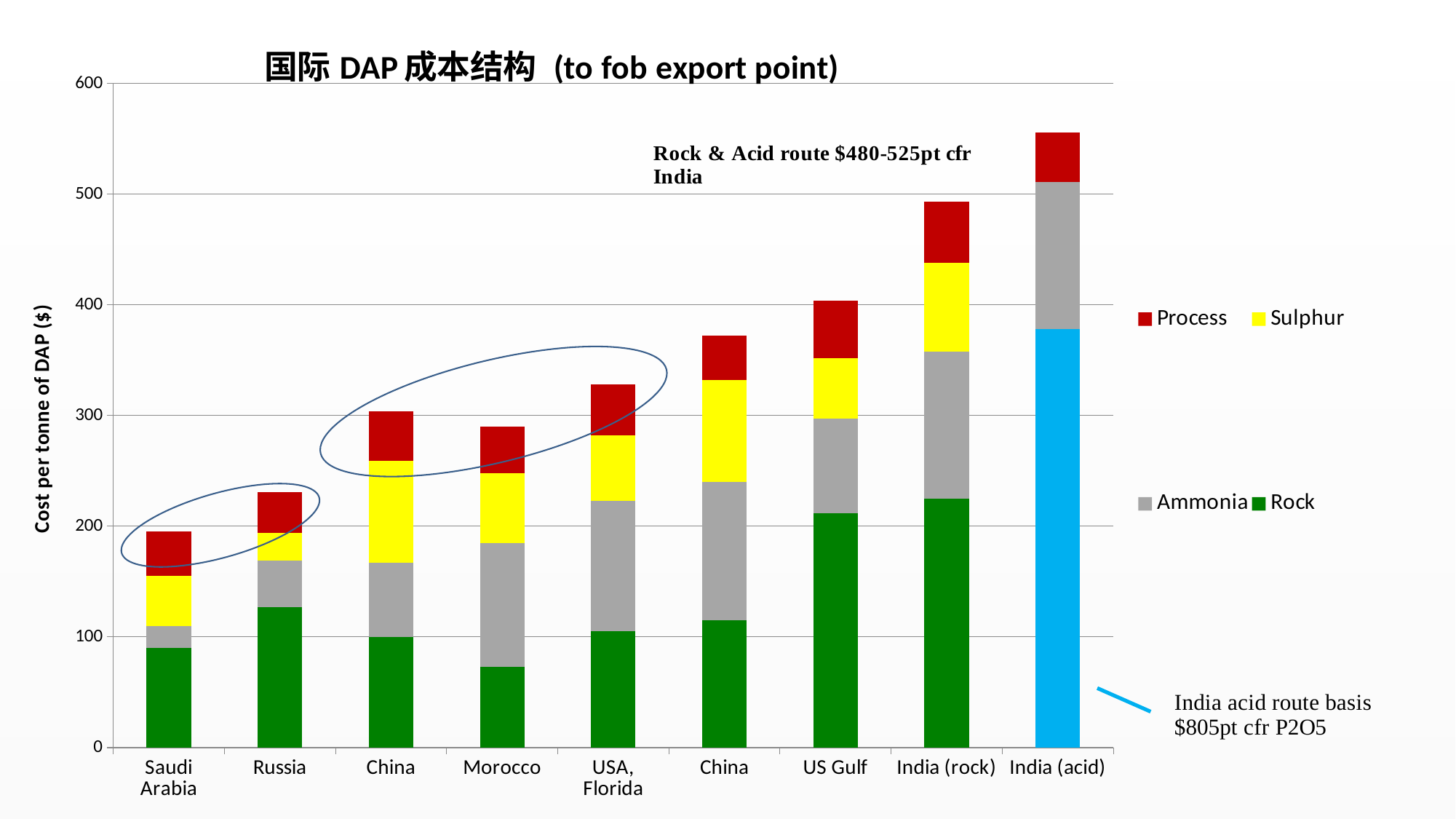
Is the total cost for Russia greater or less than 200? greater Is the total cost for Morocco greater or less than 300? less What is the label on the y axis? Cost per tonne of DAP ($) Which has a larger total cost, Russia or Morocco? Morocco What kind of chart is shown on the slide? Stacked bar chart Which category has the lowest total cost per tonne of DAP? Saudi Arabia Do the total bar heights generally rise or fall from left to right along the x axis? Rise Is the total cost for India (rock) greater or less than 500? less How many series does the legend list? 4 Which category has the highest total cost per tonne of DAP? India (acid) How many bars (categories) are plotted along the x axis? 9